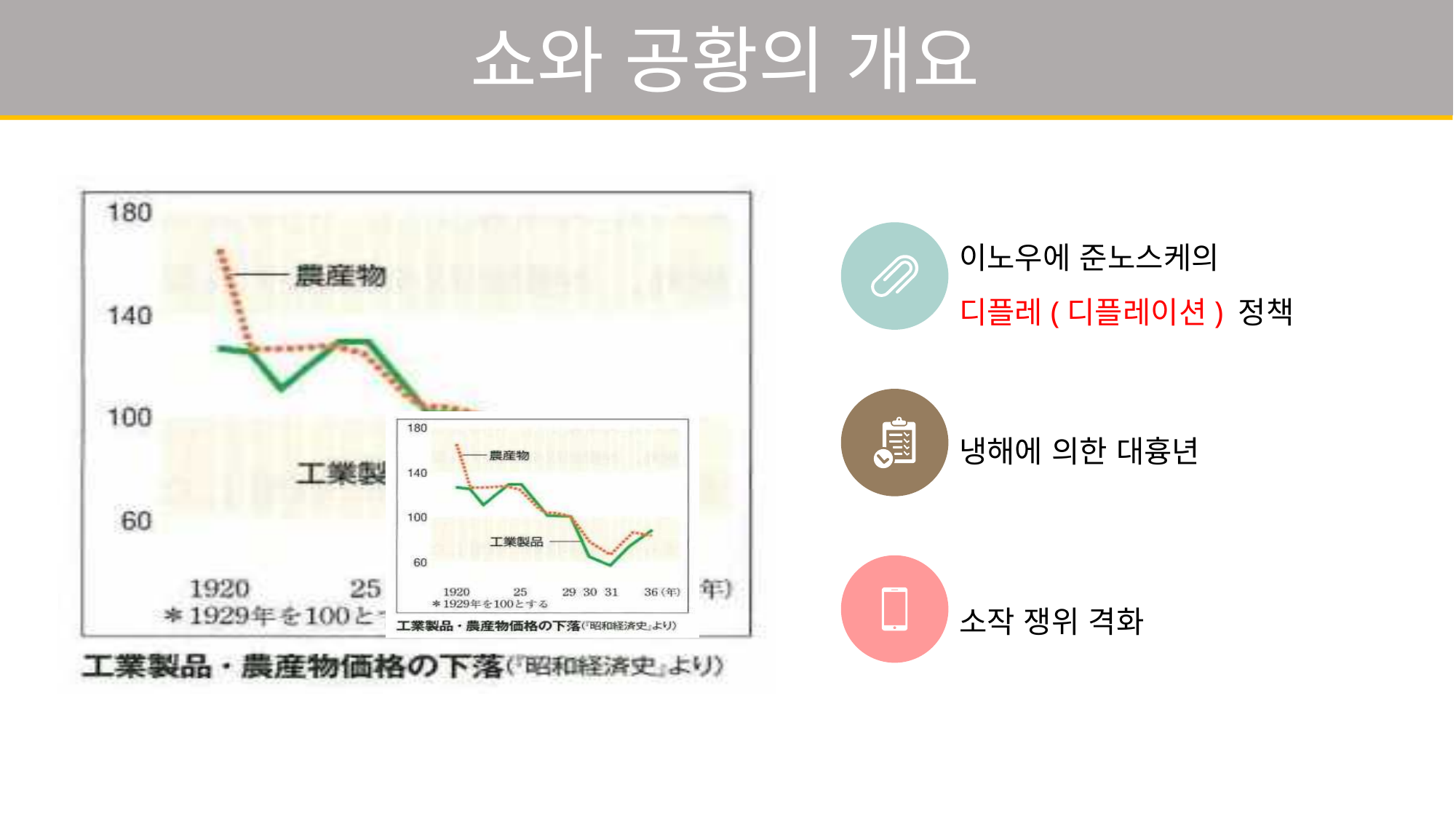
In the line chart on the left, is the value for 工業製品 in 1920 greater or less than 140? less In the line chart on the left, is the value for 工業製品 in 1931 greater or less than 100? less In the line chart on the left, what is the index value of both series in 1929, the base year? 100 What are the two series plotted in the line chart on the left? 農産物 and 工業製品 In the line chart on the left, which series has the higher value in 1920, 農産物 or 工業製品? 農産物 What kind of chart is shown on the left of the slide? line chart In the line chart on the left, in which year does 工業製品 reach its lowest value? 1931 In the line chart on the left, do the values generally rise or fall from 1920 to 1931? fall In the line chart on the left, is the value for 農産物 in 1931 greater or less than 100? less In the line chart on the left, which series is drawn with a dotted line? 農産物 How many series does the line chart on the left show? 2